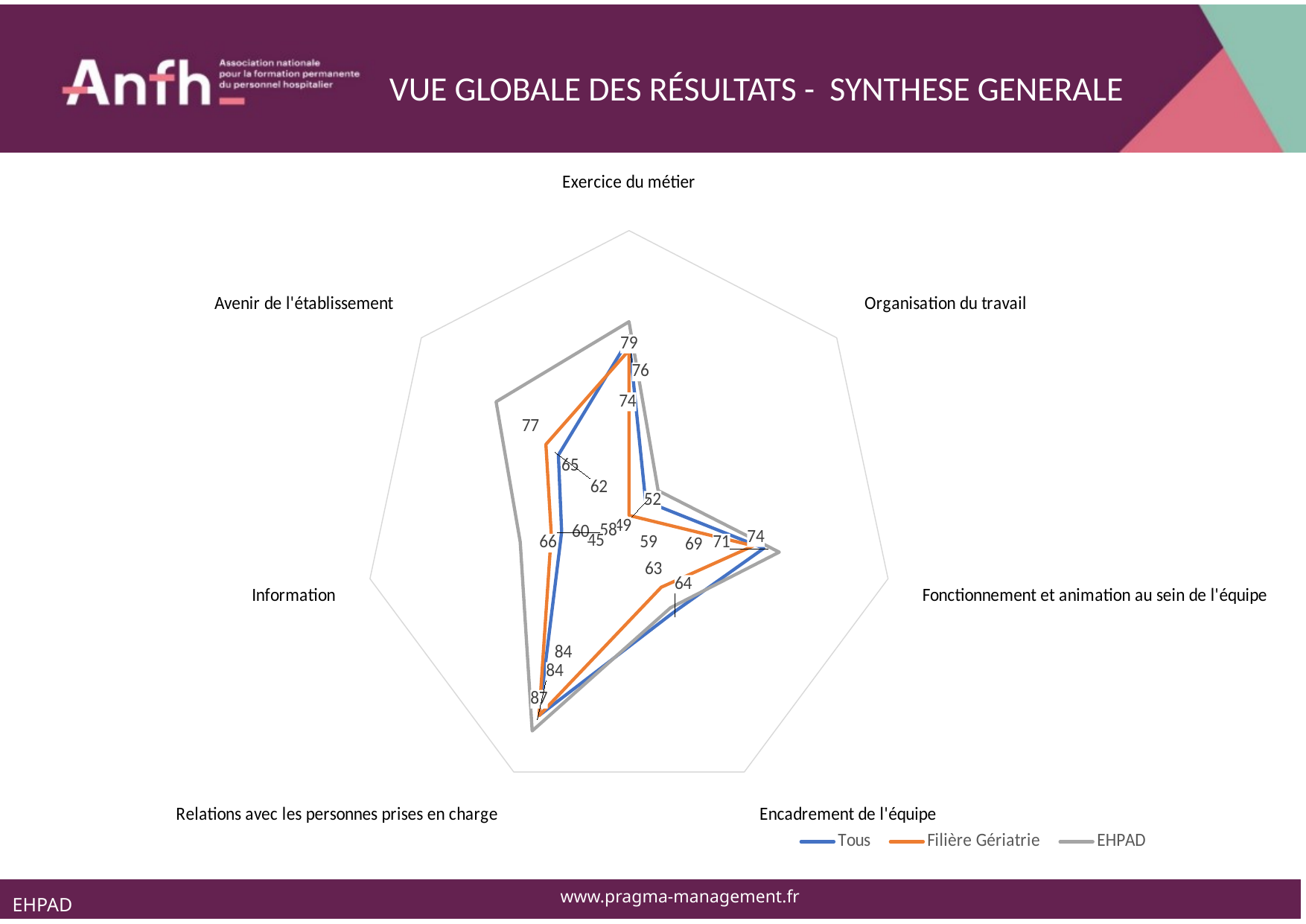
For Exercice du métier, which series has the higher value, EHPAD or Tous? EHPAD What is the value of the EHPAD series for Exercice du métier? 79 What is the value of the EHPAD series for Relations avec les personnes prises en charge? 87 What is the value of the EHPAD series for Avenir de l'établissement? 77 How many series does the legend list? 3 How many axes (categories) does the radar chart have? 7 On which axis do all three series reach their highest values? Relations avec les personnes prises en charge For Avenir de l'établissement, which series has the higher value, EHPAD or Tous? EHPAD Which series are listed in the legend? Tous, Filière Gériatrie, EHPAD What kind of chart is shown on the slide? Radar chart Which colour represents the EHPAD series? Grey What is the lowest data label printed on the chart? 45